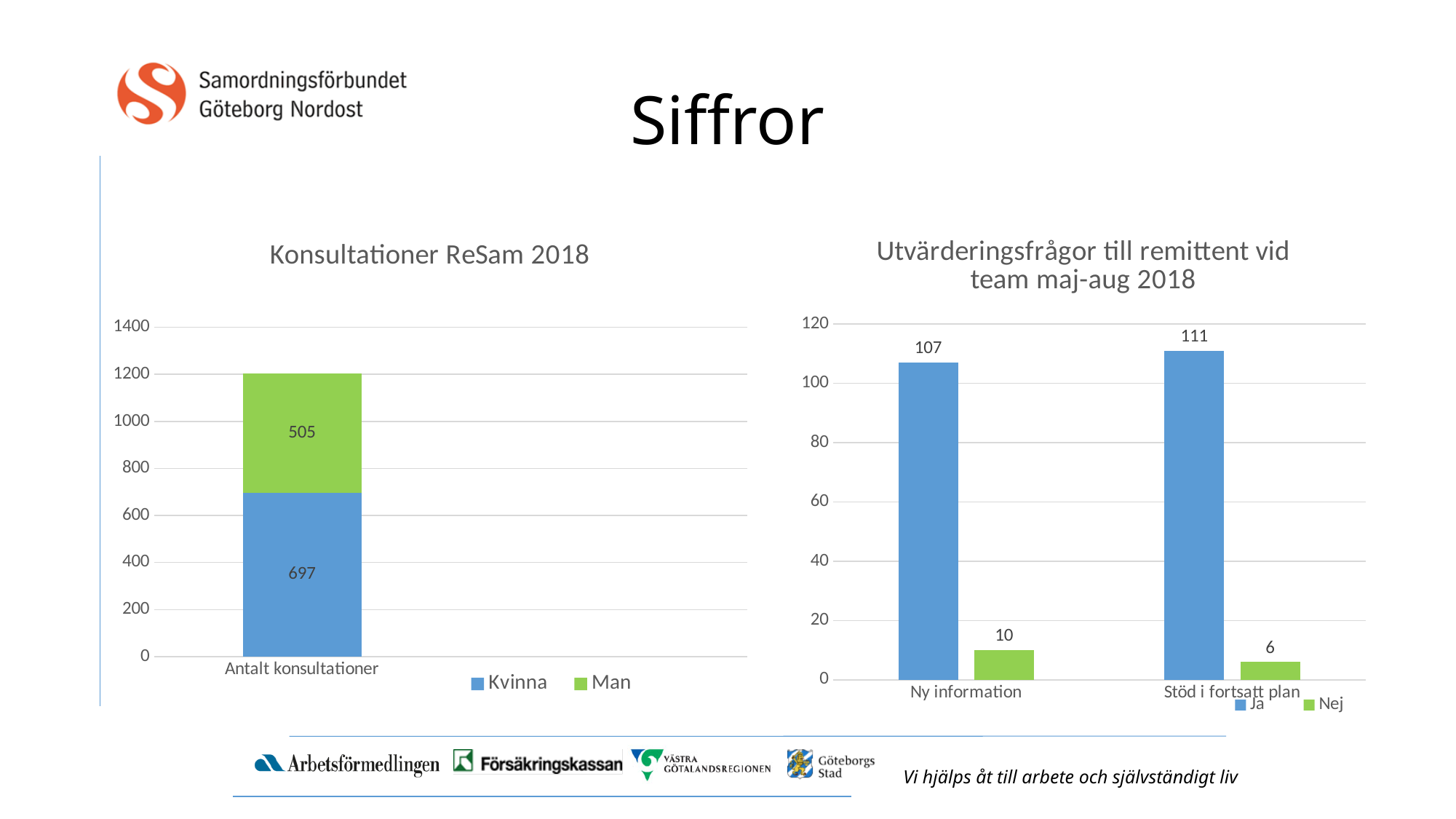
In the 'Utvärderingsfrågor till remittent vid team maj-aug 2018' chart, what is the Nej value for Stöd i fortsatt plan? 6 In the 'Utvärderingsfrågor till remittent vid team maj-aug 2018' chart, how many categories are shown on the x axis? 2 In the 'Konsultationer ReSam 2018' chart, what is the difference between the Kvinna and Man values? 192 What kind of chart is the 'Utvärderingsfrågor till remittent vid team maj-aug 2018' chart? Bar chart In the 'Konsultationer ReSam 2018' chart, which series is larger, Kvinna or Man? Kvinna In the 'Utvärderingsfrågor till remittent vid team maj-aug 2018' chart, which category has the highest Ja value? Stöd i fortsatt plan In the 'Konsultationer ReSam 2018' chart, how many series does the legend list? 2 In the 'Konsultationer ReSam 2018' chart, what is the total of the stacked bar for Antalt konsultationer? 1202 In the 'Konsultationer ReSam 2018' chart, what is the value for Kvinna? 697 In the 'Utvärderingsfrågor till remittent vid team maj-aug 2018' chart, what is the Ja value for Ny information? 107 In the 'Utvärderingsfrågor till remittent vid team maj-aug 2018' chart, what is the difference between the Ja and Nej values for Ny information? 97 In the 'Konsultationer ReSam 2018' chart, what is the value for Man? 505